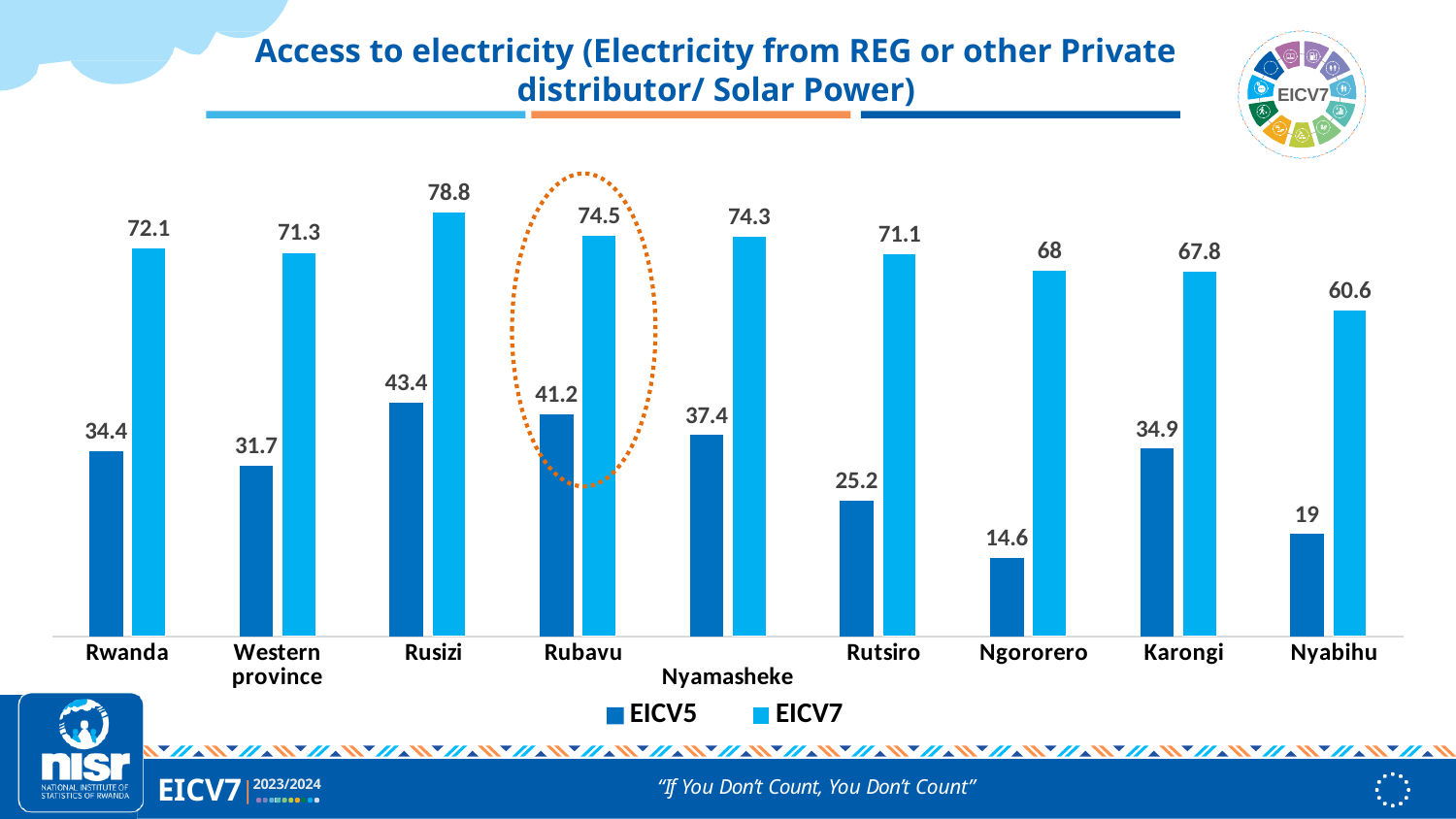
How many categories are shown on the x axis? 9 What kind of chart is shown on the slide? Bar chart What is the EICV5 value for Ngororero? 14.6 Which category has the lowest EICV5 value? Ngororero Which category has the highest EICV7 value? Rusizi How many series does the legend list? 2 What is the difference between the EICV5 values for Rusizi and Rutsiro? 18.2 What is the difference between the EICV7 and EICV5 values for Rubavu? 33.3 What is the EICV7 value for Rusizi? 78.8 What is the EICV7 value for Nyabihu? 60.6 Which is larger, the EICV5 value for Karongi or the EICV5 value for Rwanda? Karongi Which category is highlighted with a dotted orange circle? Rubavu